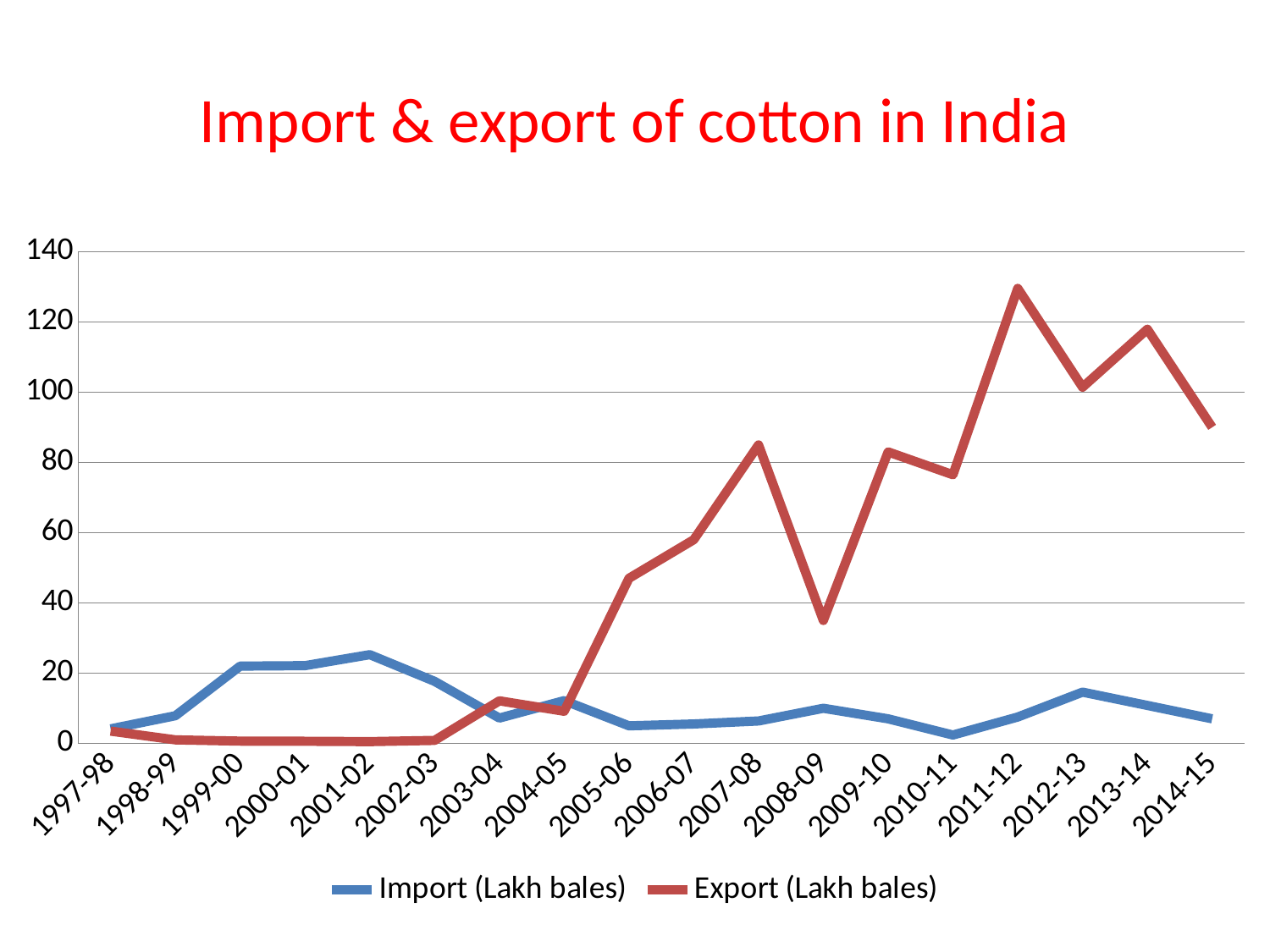
Overall, does Export (Lakh bales) rise or fall from 1997-98 to 2014-15? rise Is the Export (Lakh bales) value for 2011-12 greater or less than 120? greater Is the Export (Lakh bales) value for 2014-15 greater or less than 80? greater Which is larger in 2014-15, Import (Lakh bales) or Export (Lakh bales)? Export (Lakh bales) How many years are plotted along the x axis? 18 Which is larger in 2001-02, Import (Lakh bales) or Export (Lakh bales)? Import (Lakh bales) In which year does Export (Lakh bales) reach its highest value? 2011-12 What is the title of the chart? Import & export of cotton in India What kind of chart is shown on the slide? line chart Is the Export (Lakh bales) value for 2008-09 greater or less than 40? less How many series does the legend list? 2